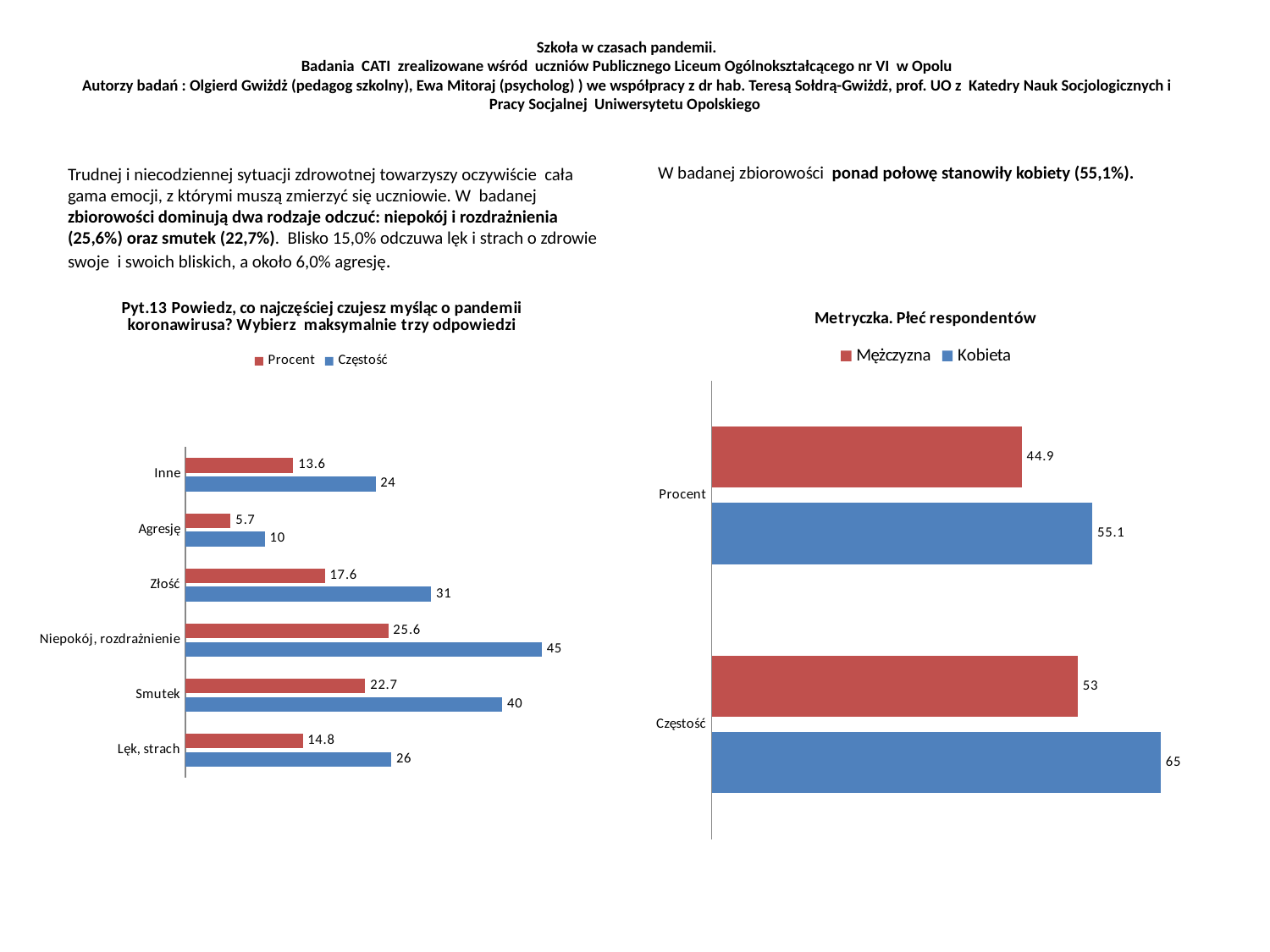
What type of chart is the right chart (Metryczka. Płeć respondentów)? Bar chart In the right chart (Metryczka. Płeć respondentów), what is the Częstość value for Mężczyzna? 53 How many series does the legend of the left chart (Pyt.13) list? 2 In the right chart (Metryczka. Płeć respondentów), what is the Procent value for Kobieta? 55.1 In the left chart (Pyt.13), which category has the highest Częstość value? Niepokój, rozdrażnienie In the left chart (Pyt.13), which category has the lowest Procent value? Agresję In the left chart (Pyt.13), what is the Procent value for Smutek? 22.7 How many categories are shown in the left chart (Pyt.13)? 6 In the left chart (Pyt.13), what is the Częstość value for Niepokój, rozdrażnienie? 45 In the right chart (Metryczka. Płeć respondentów), what is the difference between the Częstość values for Kobieta and Mężczyzna? 12 In the left chart (Pyt.13), which has a larger Procent value, Inne or Lęk, strach? Lęk, strach In the left chart (Pyt.13), what is the difference between the Częstość values for Złość and Agresję? 21